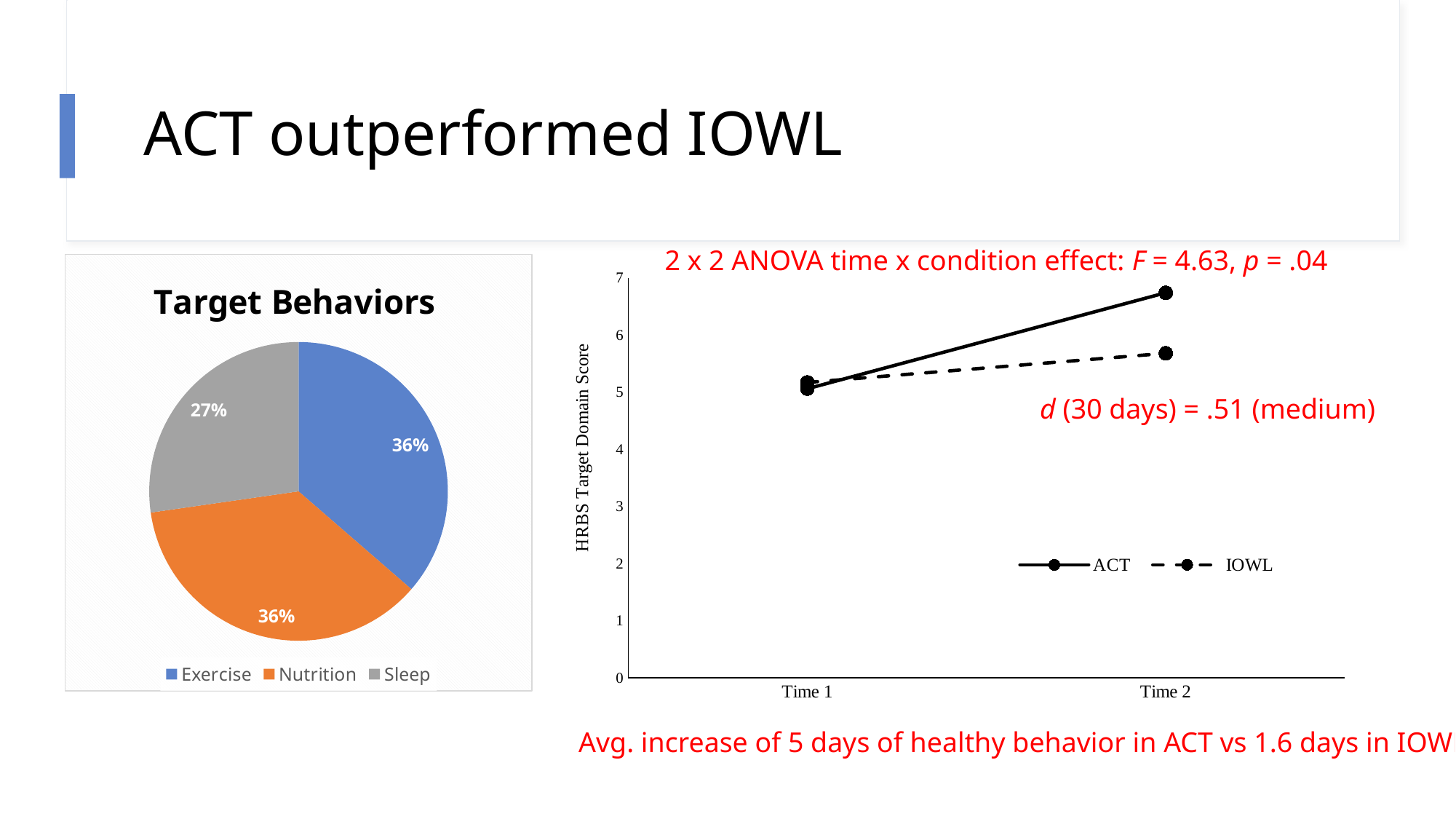
In the line chart on the right, does the ACT series rise or fall from Time 1 to Time 2? Rise In the Target Behaviors pie chart, what share does Exercise have? 36% What kind of chart is the chart on the right of the slide? Line chart In the line chart on the right, which series has the higher value at Time 2, ACT or IOWL? ACT In the line chart on the right, is the IOWL value at Time 2 greater or less than 6? less What kind of chart is the Target Behaviors chart on the left? Pie chart How many series does the legend of the line chart on the right list? 2 In the line chart on the right, is the ACT value at Time 2 greater or less than 6? greater What is the y-axis title of the line chart on the right? HRBS Target Domain Score In the Target Behaviors pie chart, what share does Sleep have? 27% How many categories does the Target Behaviors pie chart show? 3 In the Target Behaviors pie chart, which category has the smallest share? Sleep